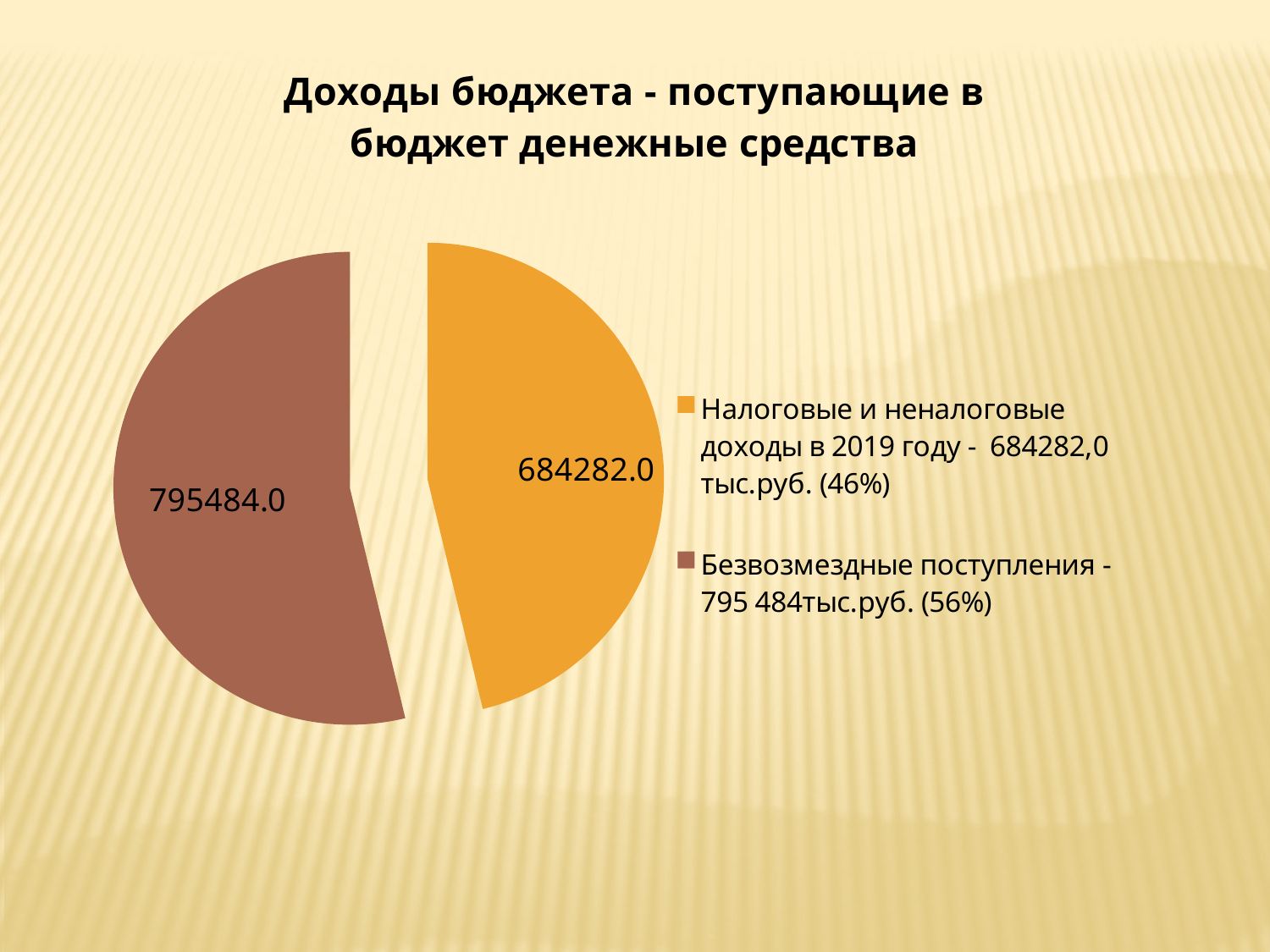
What is the value of the slice for Налоговые и неналоговые доходы в 2019 году? 684282.0 How many slices does the pie chart have? 2 What percentage share does the legend give for Налоговые и неналоговые доходы в 2019 году? 46% What is the value of the slice for Безвозмездные поступления? 795484.0 Which is larger: the value for Налоговые и неналоговые доходы or the value for Безвозмездные поступления? Безвозмездные поступления Which slice of the pie is the largest? Безвозмездные поступления What type of chart is shown on the slide? pie chart Which slice of the pie is the smallest? Налоговые и неналоговые доходы в 2019 году What percentage share does the legend give for Безвозмездные поступления? 56% What is the difference between the value for Безвозмездные поступления and the value for Налоговые и неналоговые доходы? 111202.0 How many entries does the legend list? 2 What is the title of the chart on the slide? Доходы бюджета - поступающие в бюджет денежные средства